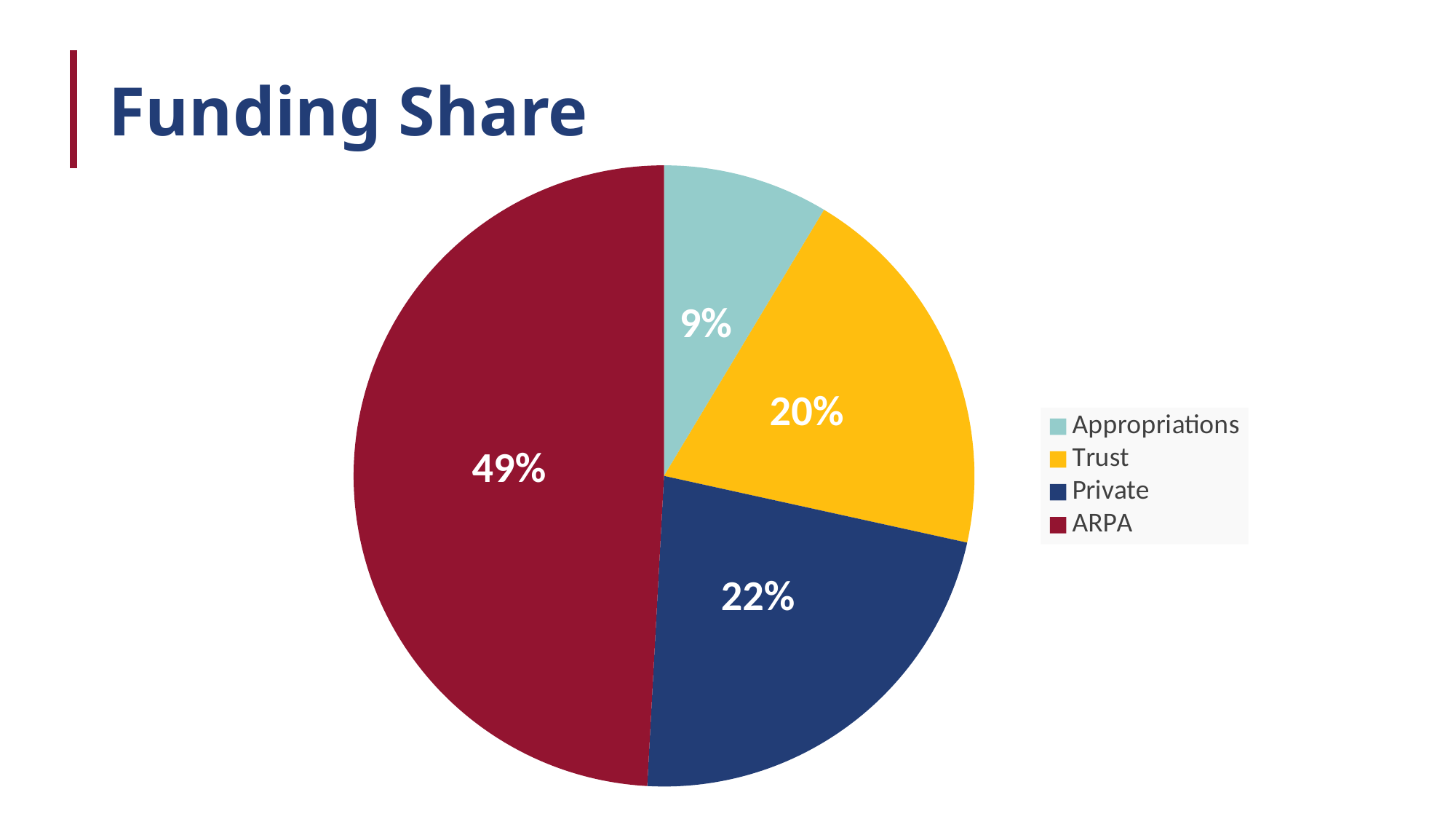
Which funding source has the smallest share? Appropriations What kind of chart is shown on the slide? Pie chart What is the title of the chart? Funding Share What share of funding comes from Appropriations? 9% What share of funding does ARPA account for? 49% What share of funding comes from Private sources? 22% Which has a larger share, Private or Trust? Private What is the difference in share between Trust and Appropriations? 11% What is the difference in share between ARPA and Private? 27% How many slices does the pie chart have? 4 Which funding source has the largest share? ARPA